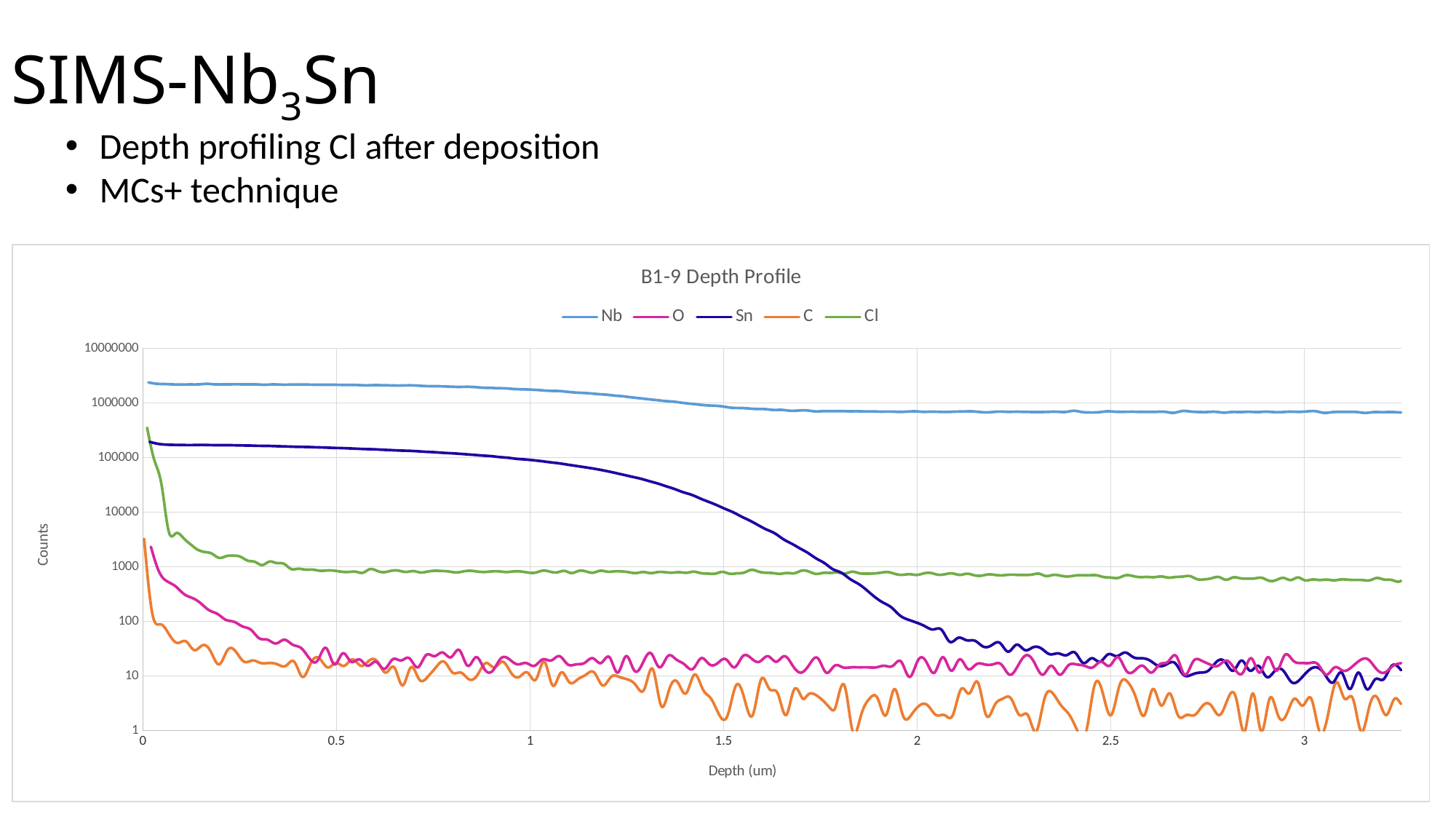
Is the Nb value at depth 0 greater or less than 1000000? greater How many series does the legend list? 5 Is the Sn value at a depth of 2.5 um greater or less than 100? less What is the label of the x axis? Depth (um) Do the Sn counts rise or fall as depth increases? fall What kind of chart is shown on the slide? line chart At a depth of 0.5 um, which series has the larger counts, Sn or Cl? Sn Is the Cl value at a depth of 3 um greater or less than 1000? less Which series has the highest counts across the whole depth range? Nb Which series has the lowest counts at a depth of 3 um? C At a depth of 1 um, which series has the larger counts, Cl or O? Cl What is the title of the chart? B1-9 Depth Profile